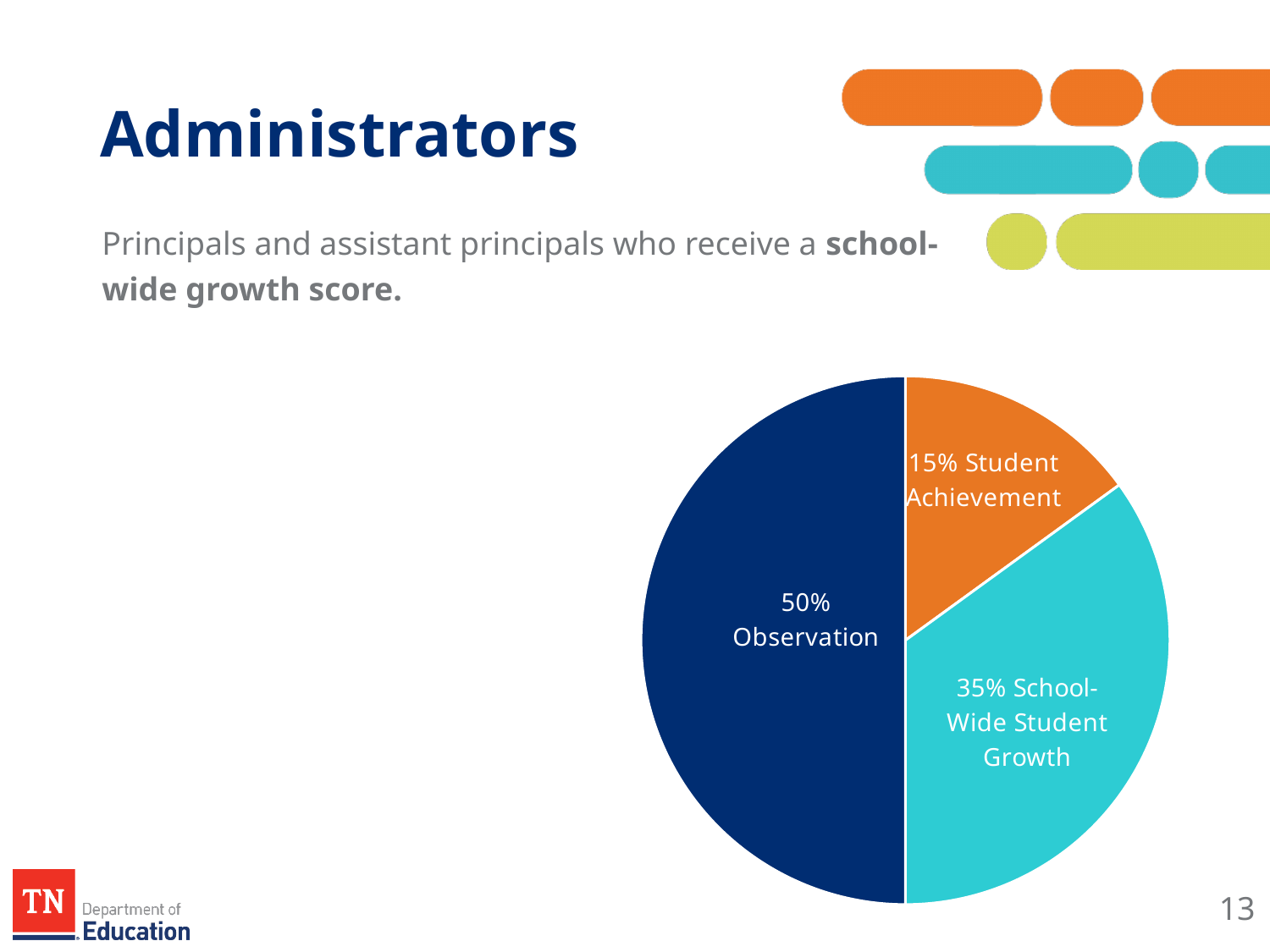
How many slices does the pie chart have? 3 What share of the pie does Observation represent? 50% What colour is the Student Achievement slice? Orange What share of the pie does Student Achievement represent? 15% What share of the pie does School-Wide Student Growth represent? 35% Which slice of the pie is the smallest? Student Achievement What is the difference in percentage points between School-Wide Student Growth and Student Achievement? 20 Which is larger, the School-Wide Student Growth slice or the Student Achievement slice? School-Wide Student Growth What is the difference in percentage points between Observation and School-Wide Student Growth? 15 What kind of chart is shown on the slide? Pie chart What colour is the Observation slice? Dark blue Which slice of the pie is the largest? Observation